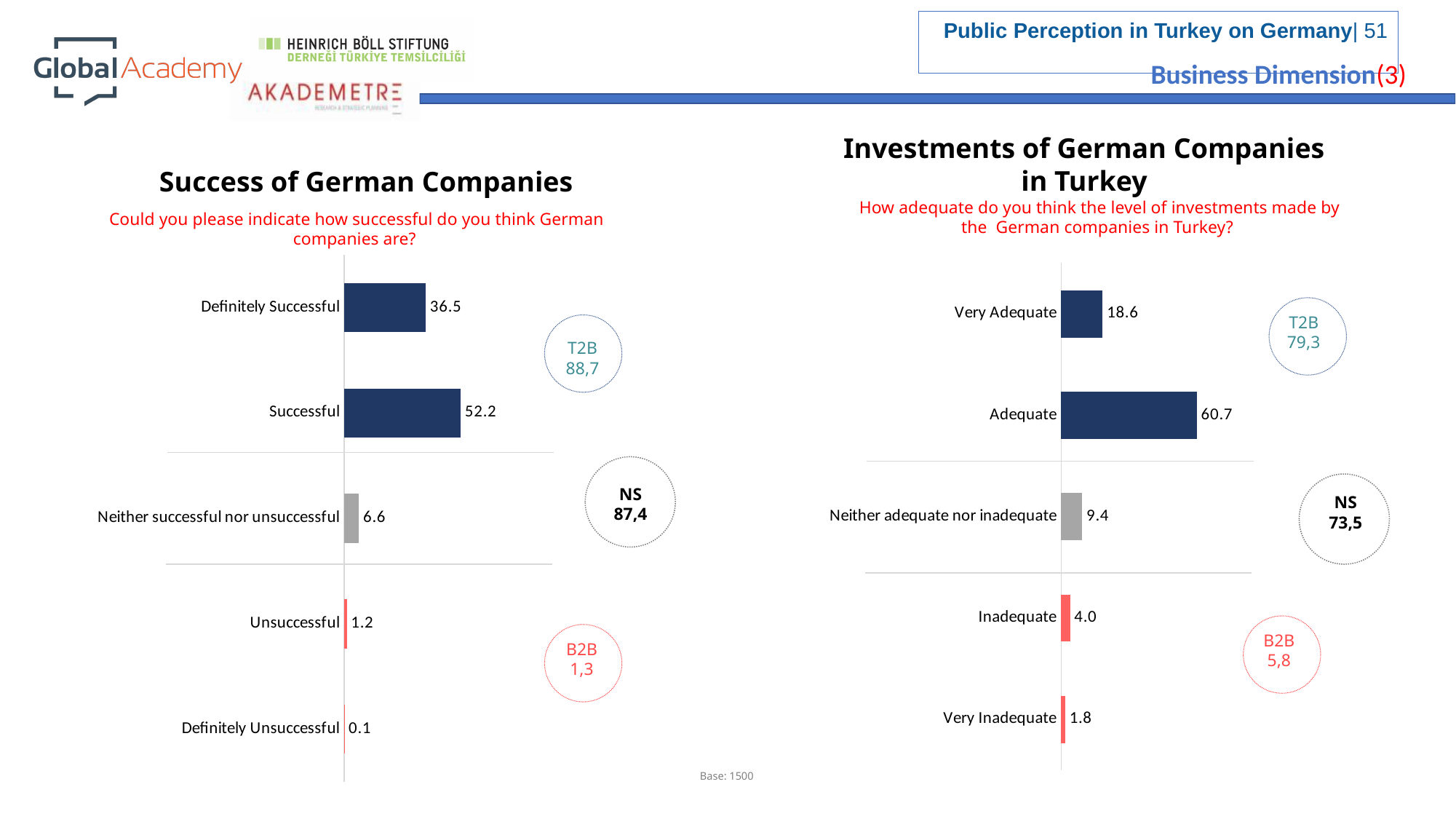
In the 'Investments of German Companies in Turkey' chart, what is the value for 'Adequate'? 60.7 In the 'Investments of German Companies in Turkey' chart, what is the value for 'Very Inadequate'? 1.8 How many categories are shown in the 'Success of German Companies' chart? 5 In the 'Investments of German Companies in Turkey' chart, what is the difference between 'Adequate' and 'Very Adequate'? 42.1 In the 'Success of German Companies' chart, what is the value for 'Definitely Unsuccessful'? 0.1 In the 'Investments of German Companies in Turkey' chart, which is larger: 'Neither adequate nor inadequate' or 'Inadequate'? Neither adequate nor inadequate What type of chart is the 'Investments of German Companies in Turkey' chart? Bar chart In the 'Success of German Companies' chart, what is the value for 'Successful'? 52.2 In the 'Investments of German Companies in Turkey' chart, which category has the lowest value? Very Inadequate In the 'Success of German Companies' chart, which category has the highest value? Successful In the 'Success of German Companies' chart, what is the difference between 'Successful' and 'Definitely Successful'? 15.7 What is the T2B value shown next to the 'Success of German Companies' chart? 88,7